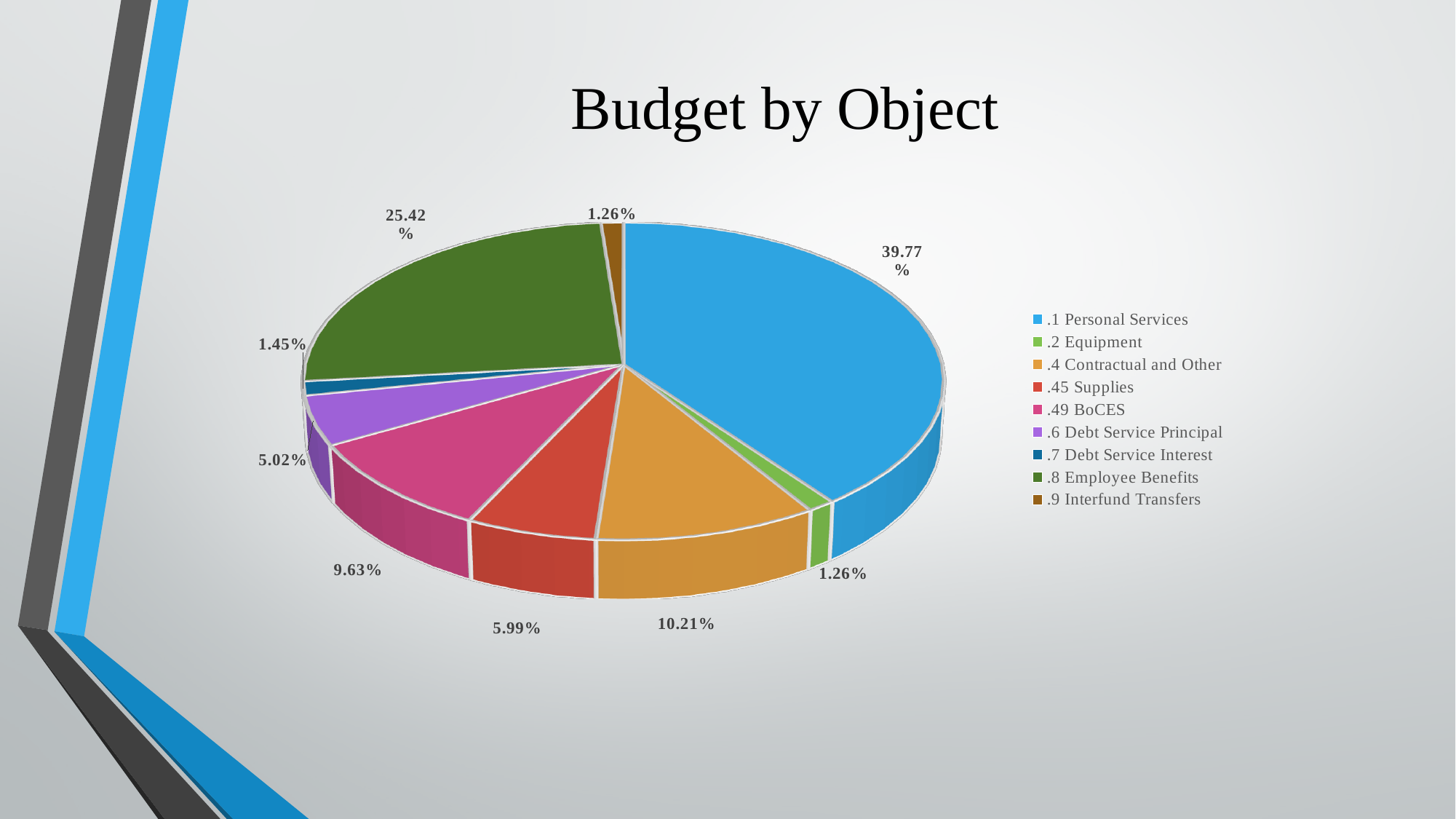
How many categories are shown in the pie chart? 9 Which is larger, the share for .45 Supplies or the share for .6 Debt Service Principal? .45 Supplies What is the difference between the shares of .1 Personal Services and .8 Employee Benefits? 14.35% What is the value shown for .49 BoCES? 9.63% What share of the budget is .8 Employee Benefits? 25.42% What is the difference between the shares of .49 BoCES and .45 Supplies? 3.64% What type of chart is shown on the slide? pie chart What is the value shown for .7 Debt Service Interest? 1.45% Which category has the largest share of the budget? .1 Personal Services What share of the budget is .1 Personal Services? 39.77% What is the value shown for .4 Contractual and Other? 10.21% What is the title of the chart? Budget by Object